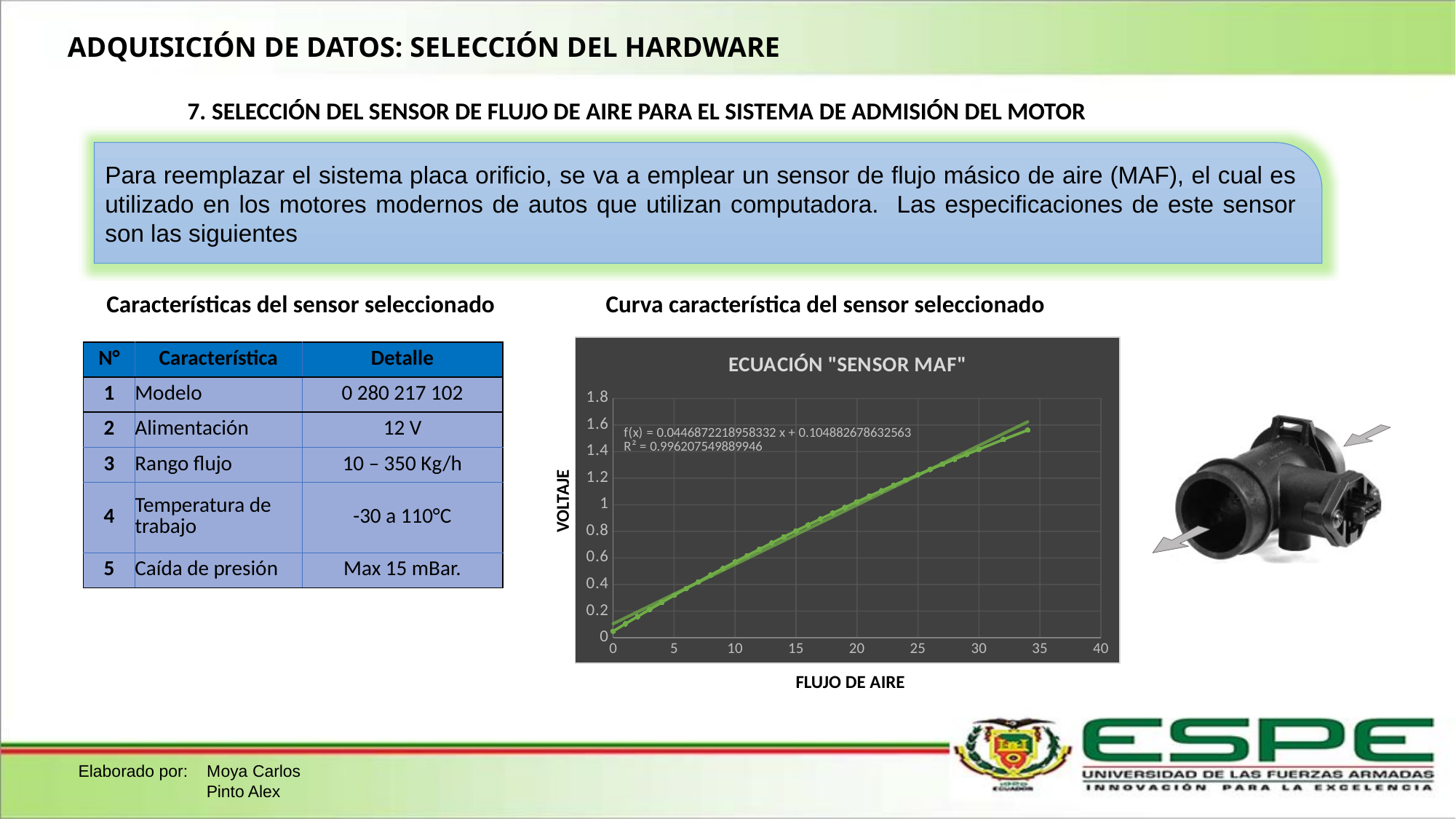
Do the values in the "ECUACIÓN "SENSOR MAF"" chart rise or fall as FLUJO DE AIRE increases? rise In the "ECUACIÓN "SENSOR MAF"" chart, is the VOLTAJE value at FLUJO DE AIRE 10 greater or less than 0.8? less What kind of chart is shown under "Curva característica del sensor seleccionado"? line chart What is the label of the vertical axis of the chart? VOLTAJE What is the highest tick value shown on the VOLTAJE axis of the chart? 1.8 In the "ECUACIÓN "SENSOR MAF"" chart, is the VOLTAJE value at FLUJO DE AIRE 5 greater or less than 0.6? less In the "ECUACIÓN "SENSOR MAF"" chart, is the VOLTAJE value at FLUJO DE AIRE 20 greater or less than 1.2? less What is the title of the chart on the slide? ECUACIÓN "SENSOR MAF" What is the highest tick value shown on the horizontal axis of the chart? 40 What R² value is printed on the "ECUACIÓN "SENSOR MAF"" chart? R² = 0.996207549889946